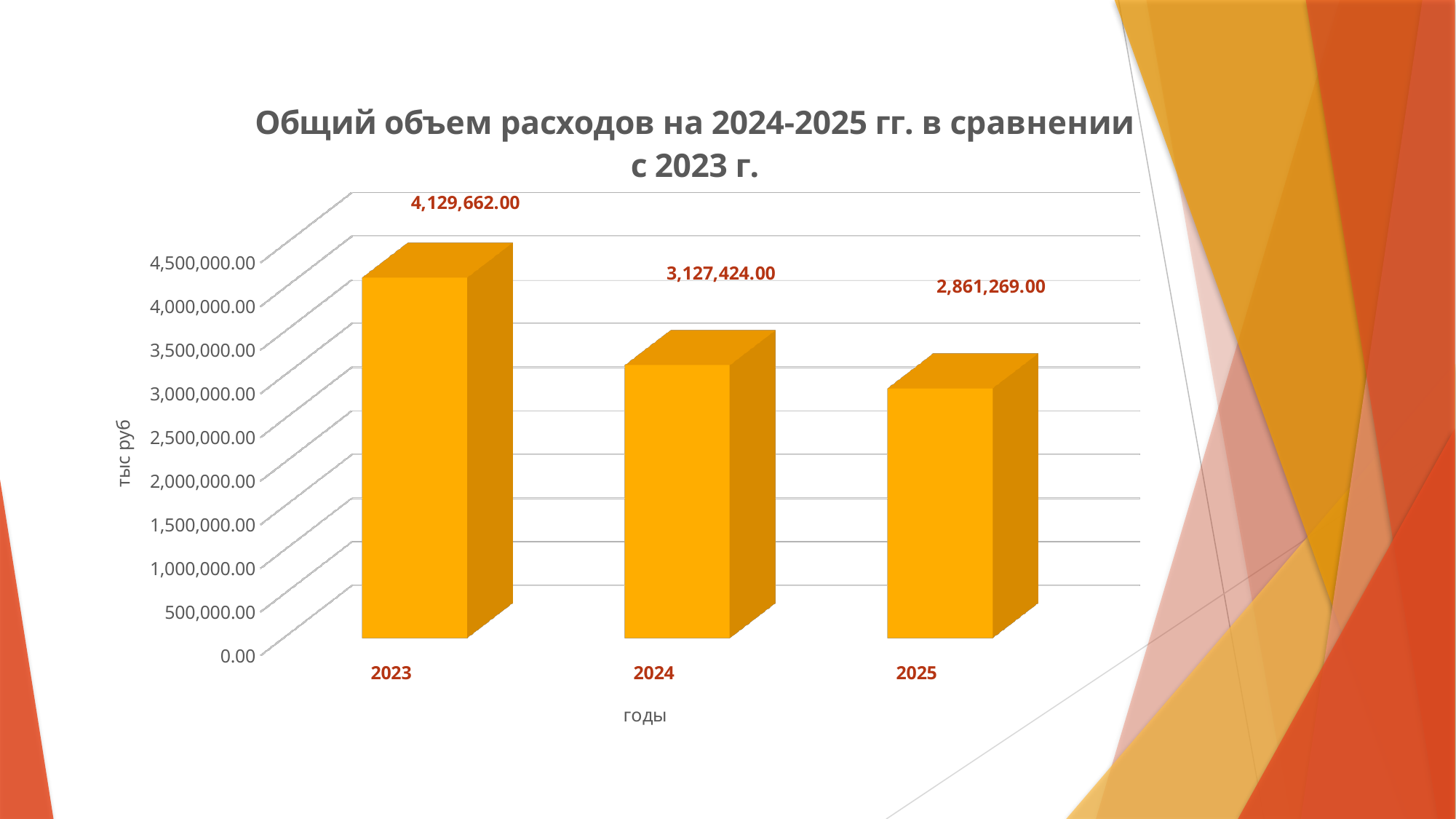
What is the difference between the values for 2024 and 2025? 266,155.00 What kind of chart is this? bar chart Is the value for 2025 greater or less than 3,000,000.00? less Do the values rise or fall from 2023 to 2025? fall Which is larger, the value for 2024 or the value for 2025? 2024 Which year has the lowest value? 2025 What is the value for 2023? 4,129,662.00 What is the value for 2024? 3,127,424.00 What is the difference between the values for 2023 and 2024? 1,002,238.00 Which year has the highest value? 2023 How many years are shown on the x axis? 3 What is the value for 2025? 2,861,269.00